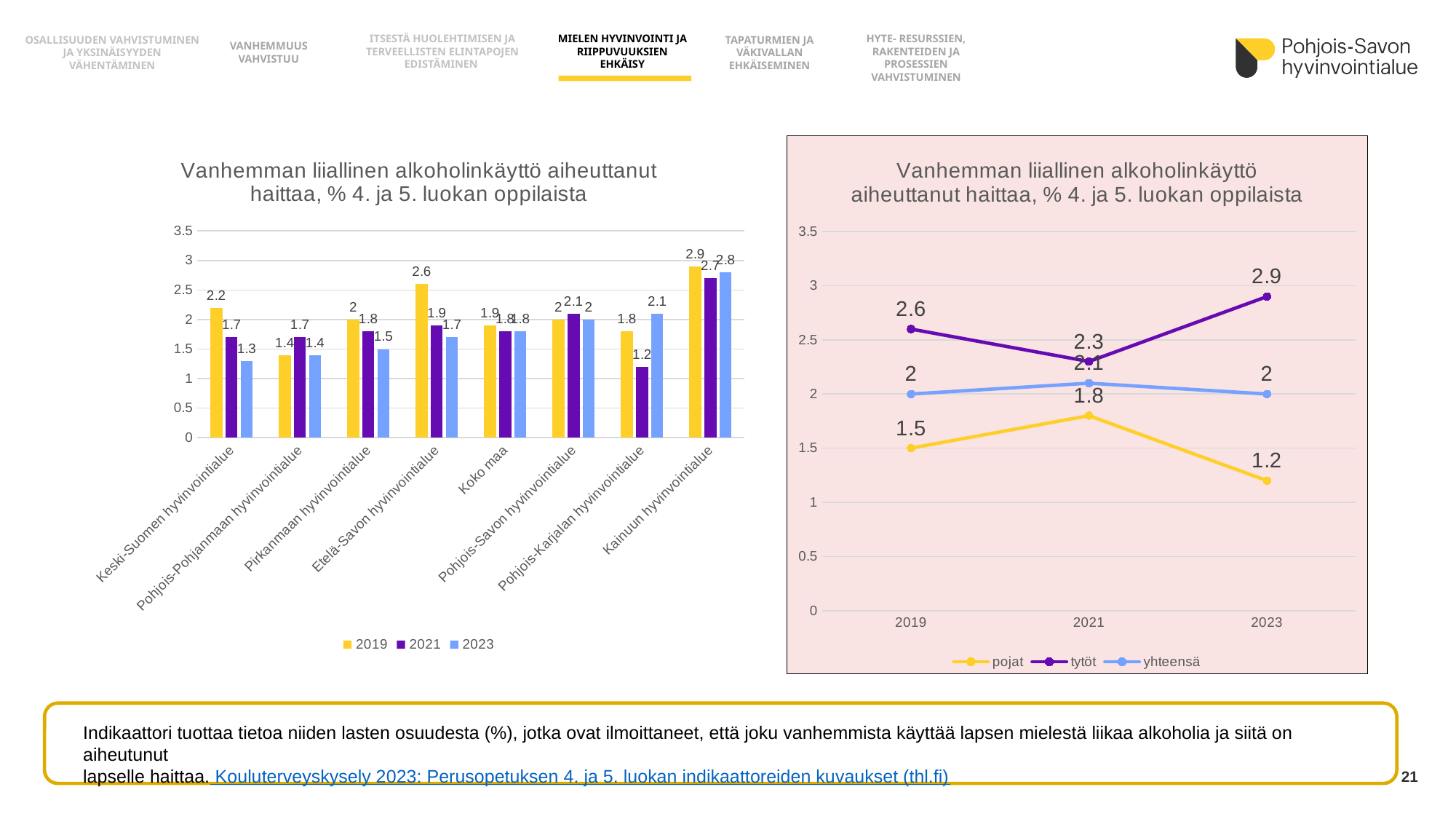
In the bar chart on the left, what is the 2023 value for Pohjois-Karjalan hyvinvointialue? 2.1 In the bar chart on the left, what is the difference between the 2019 and 2023 values for Keski-Suomen hyvinvointialue? 0.9 In the line chart on the right, which series has the highest value in 2019? tytöt In the line chart on the right, what is the value for pojat in 2021? 1.8 In the bar chart on the left, how many regions (categories) are shown on the x axis? 8 In the bar chart on the left, which region has the lowest 2021 value? Pohjois-Karjalan hyvinvointialue In the bar chart on the left, what is the 2019 value for Etelä-Savon hyvinvointialue? 2.6 In the bar chart on the left, how many series does the legend list? 3 In the line chart on the right, what is the difference between tytöt and pojat in 2023? 1.7 In the bar chart on the left, which region has the highest 2019 value? Kainuun hyvinvointialue In the line chart on the right, what is the value for tytöt in 2023? 2.9 What kind of chart is the chart on the right? line chart